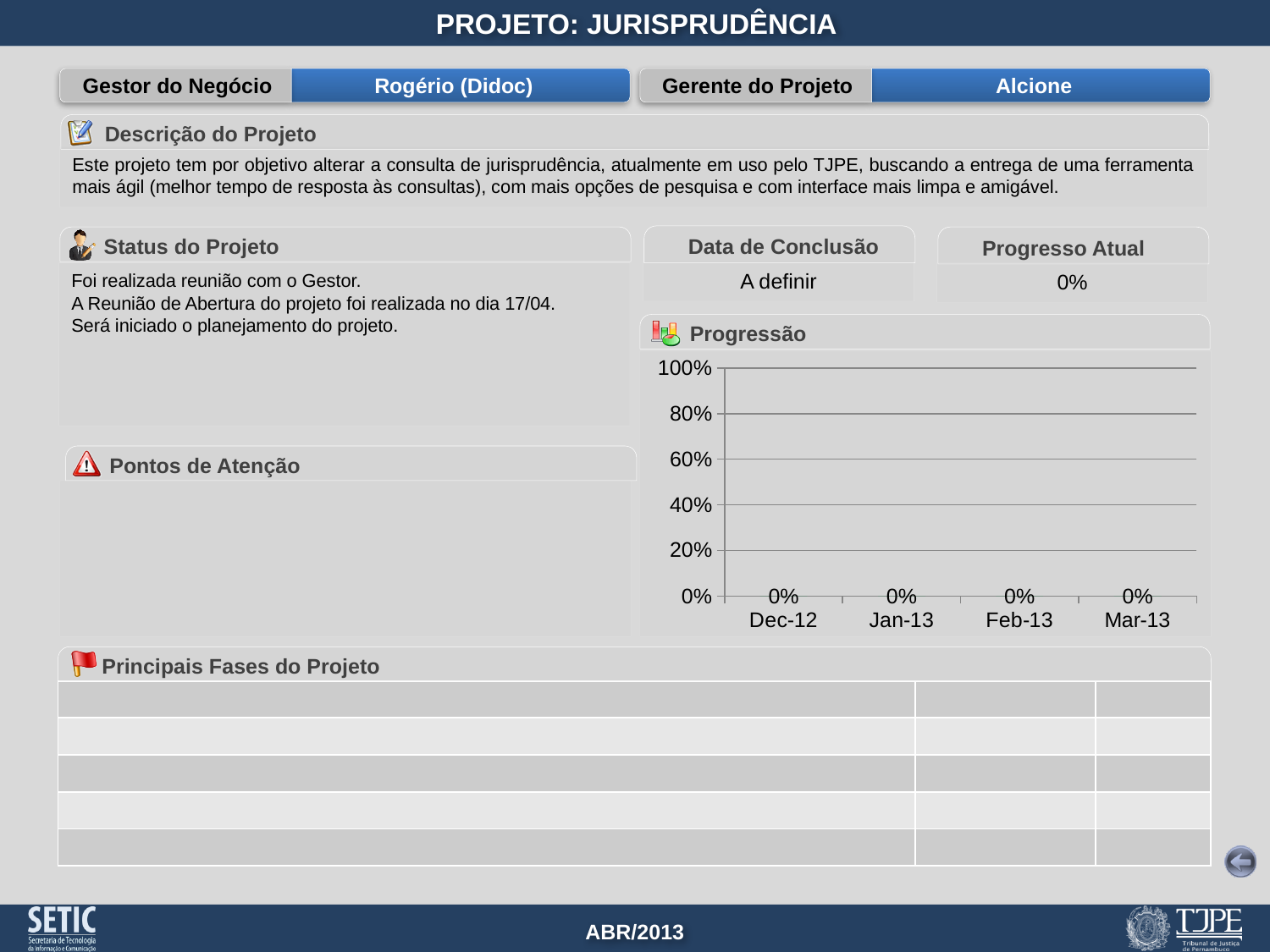
Is the value for Feb-13 in the Progressão chart greater or less than 20%? less What is the value for Jan-13 in the Progressão chart? 0% How many categories are shown on the x axis of the Progressão chart? 4 What is the difference between the values for Mar-13 and Dec-12 in the Progressão chart? 0% What is the highest value shown on the y axis of the Progressão chart? 100% What is the value for Mar-13 in the Progressão chart? 0% What is the value for Feb-13 in the Progressão chart? 0% Which is the first category on the x axis of the Progressão chart? Dec-12 What is the value for Dec-12 in the Progressão chart? 0% What is the title of the chart on the slide? Progressão Do the values in the Progressão chart rise, fall or stay flat from Dec-12 to Mar-13? stay flat